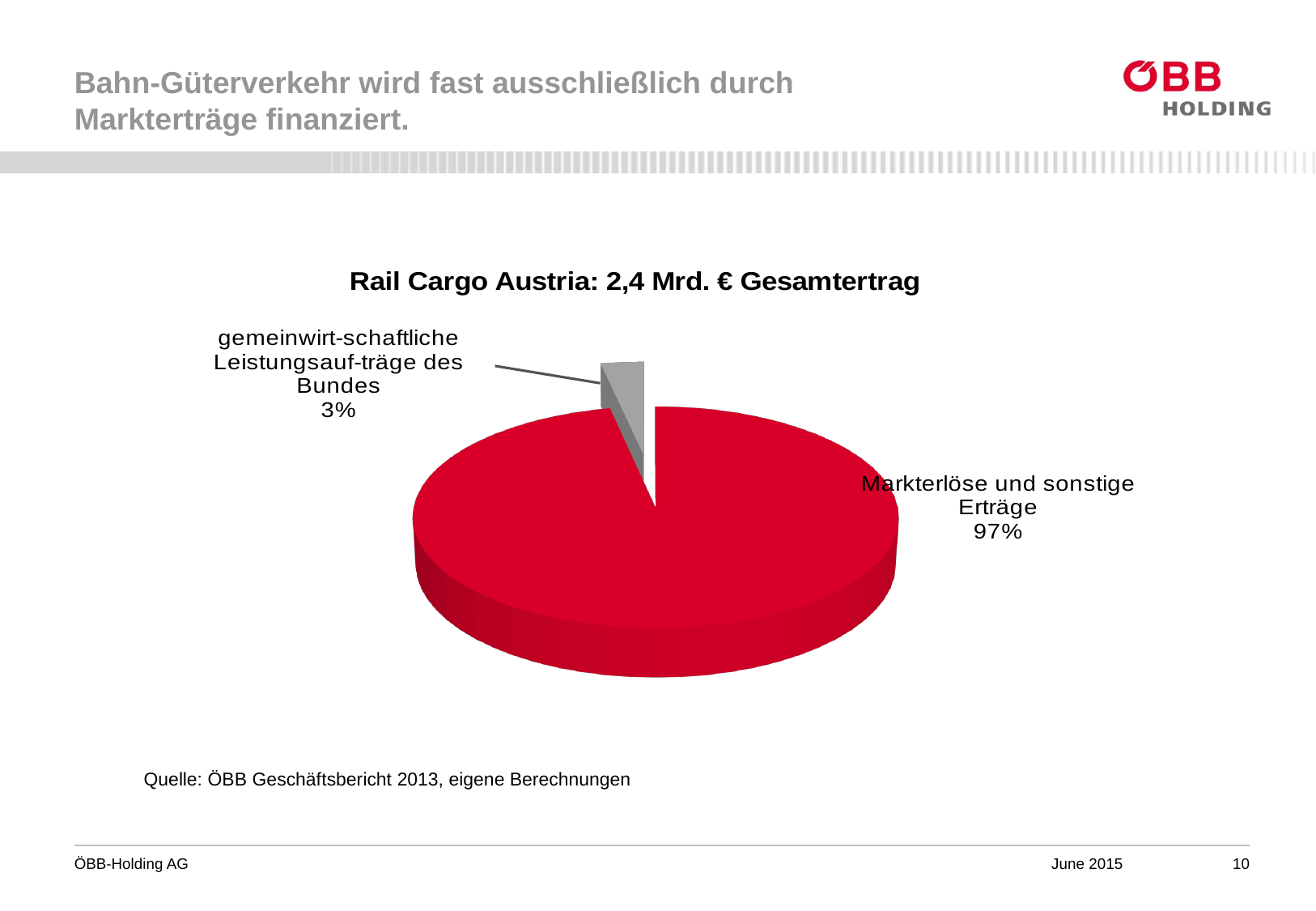
Which slice of the pie is the smallest? gemeinwirtschaftliche Leistungsaufträge des Bundes Which is larger: the share for 'Markterlöse und sonstige Erträge' or the share for 'gemeinwirtschaftliche Leistungsaufträge des Bundes'? Markterlöse und sonstige Erträge What share of the pie is labelled 'Markterlöse und sonstige Erträge'? 97% What is the difference in percentage points between the 'Markterlöse und sonstige Erträge' slice and the 'gemeinwirtschaftliche Leistungsaufträge des Bundes' slice? 94 percentage points Which slice of the pie is the largest? Markterlöse und sonstige Erträge What total amount (Gesamtertrag) does the chart title state for Rail Cargo Austria? 2,4 Mrd. € What type of chart is shown on the slide? Pie chart What is the title of the chart? Rail Cargo Austria: 2,4 Mrd. € Gesamtertrag What colour is the 'Markterlöse und sonstige Erträge' slice? Red What share of the pie is labelled 'gemeinwirtschaftliche Leistungsaufträge des Bundes'? 3% How many slices does the pie chart have? 2